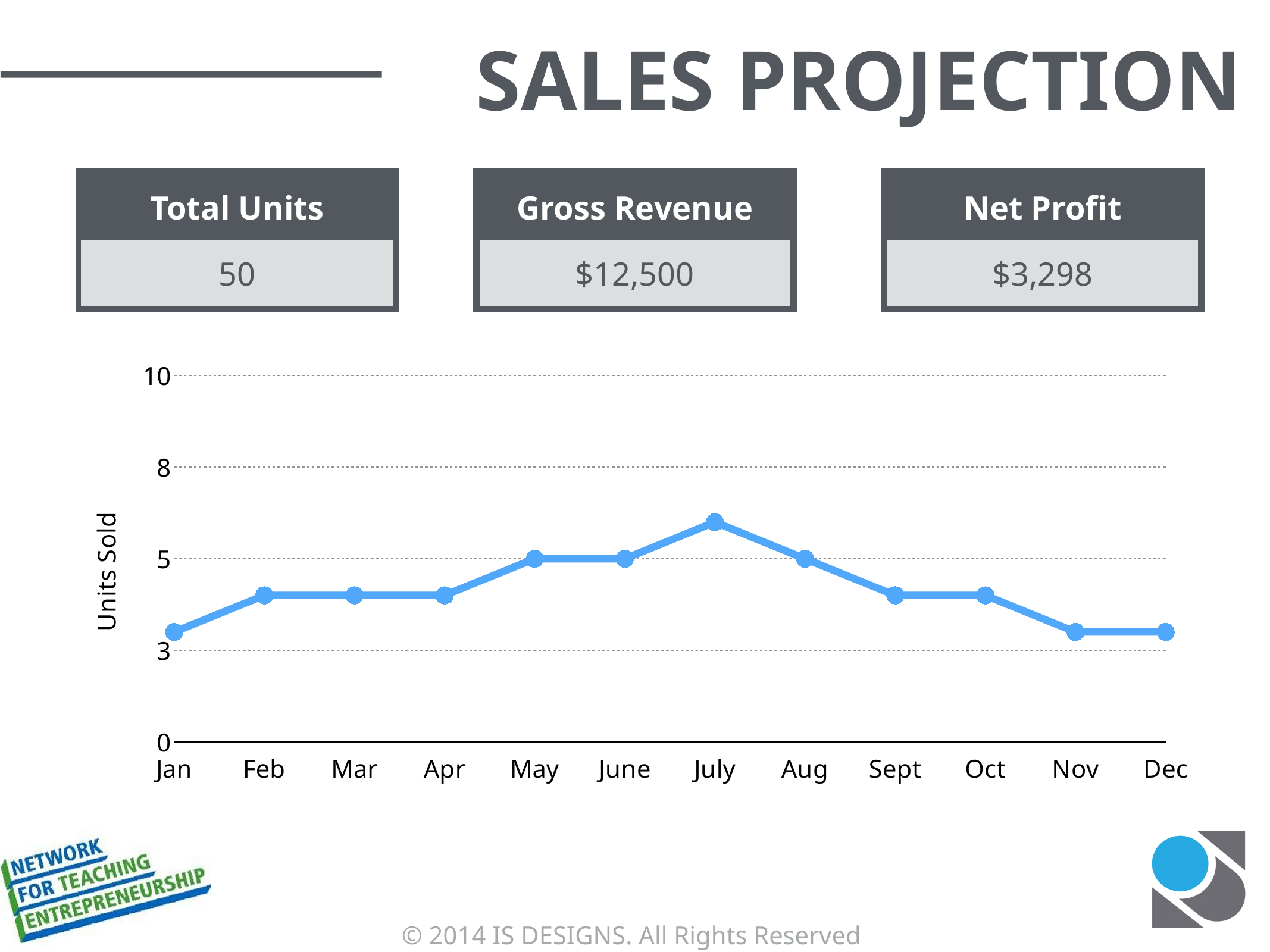
What is the value for Aug in the chart? 5 Do the values rise or fall from Jan to July in the chart? rise Is the value for July greater or less than 5? greater What kind of chart is shown on the slide? line chart Is the value for Jan greater or less than 5? less What is the label on the y axis of the chart? Units Sold Which month has the highest units sold in the chart? July Is the value for Feb greater or less than 5? less What is the value for May in the chart? 5 Which is larger, the value for July or the value for Nov? July What is the value for June in the chart? 5 How many months are plotted on the x axis of the chart? 12